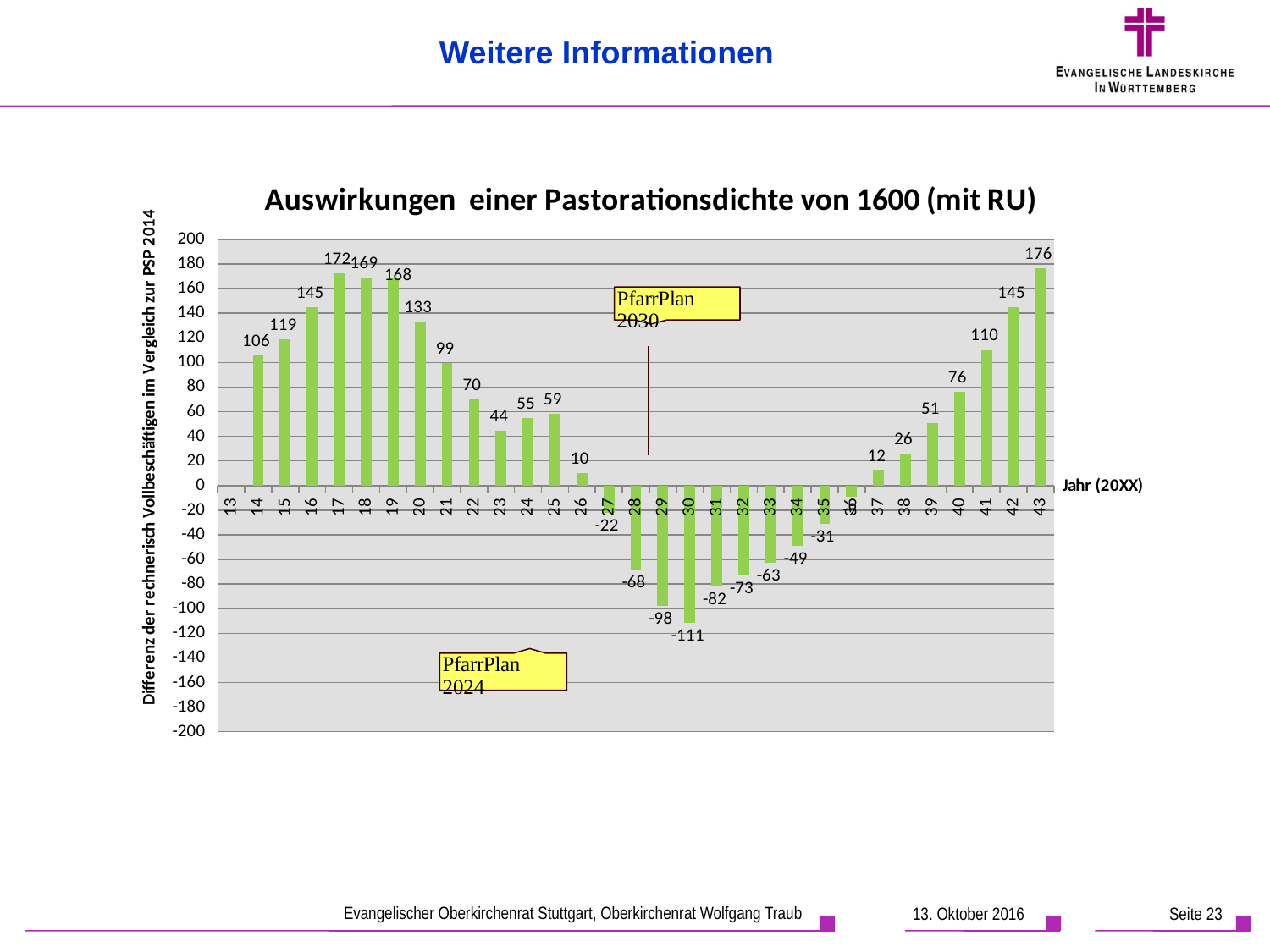
Do the values rise or fall from year 17 to year 30? Fall How many years are shown on the x axis of the chart? 31 What is the value for year 30 in the chart? -111 What is the value for year 26 in the chart? 10 What kind of chart is shown on the slide? Bar chart What is the difference between the values for year 43 and year 17? 4 Is the value for year 40 greater or less than 60? greater Which year has the highest value in the chart? 43 Which is larger, the value for year 20 or the value for year 41? Year 20 What is the difference between the values for year 28 and year 29? 30 Which year has the lowest value in the chart? 30 What is the value for year 17 in the chart? 172